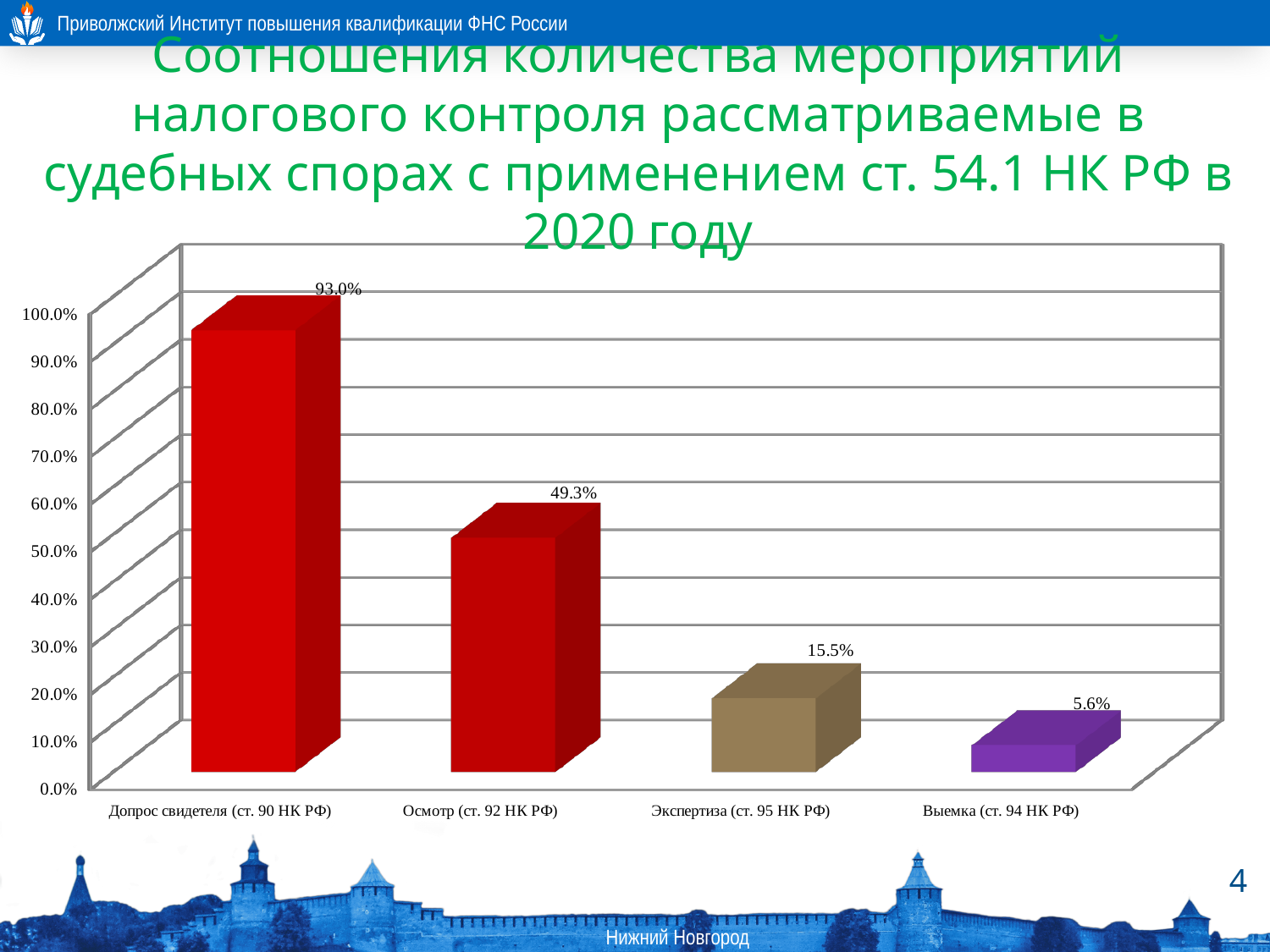
Which category has the highest value? Допрос свидетеля (ст. 90 НК РФ) What is the value for Допрос свидетеля (ст. 90 НК РФ)? 93.0% Which is larger, the value for Осмотр (ст. 92 НК РФ) or the value for Экспертиза (ст. 95 НК РФ)? Осмотр (ст. 92 НК РФ) What is the value for Экспертиза (ст. 95 НК РФ)? 15.5% What is the difference between the values for Экспертиза (ст. 95 НК РФ) and Выемка (ст. 94 НК РФ)? 9.9% What kind of chart is shown on the slide? Bar chart Which category has the lowest value? Выемка (ст. 94 НК РФ) What is the value for Выемка (ст. 94 НК РФ)? 5.6% What is the difference between the values for Допрос свидетеля (ст. 90 НК РФ) and Осмотр (ст. 92 НК РФ)? 43.7% How many categories are shown on the chart? 4 Do the values rise or fall from left to right across the categories? Fall What is the value for Осмотр (ст. 92 НК РФ)? 49.3%